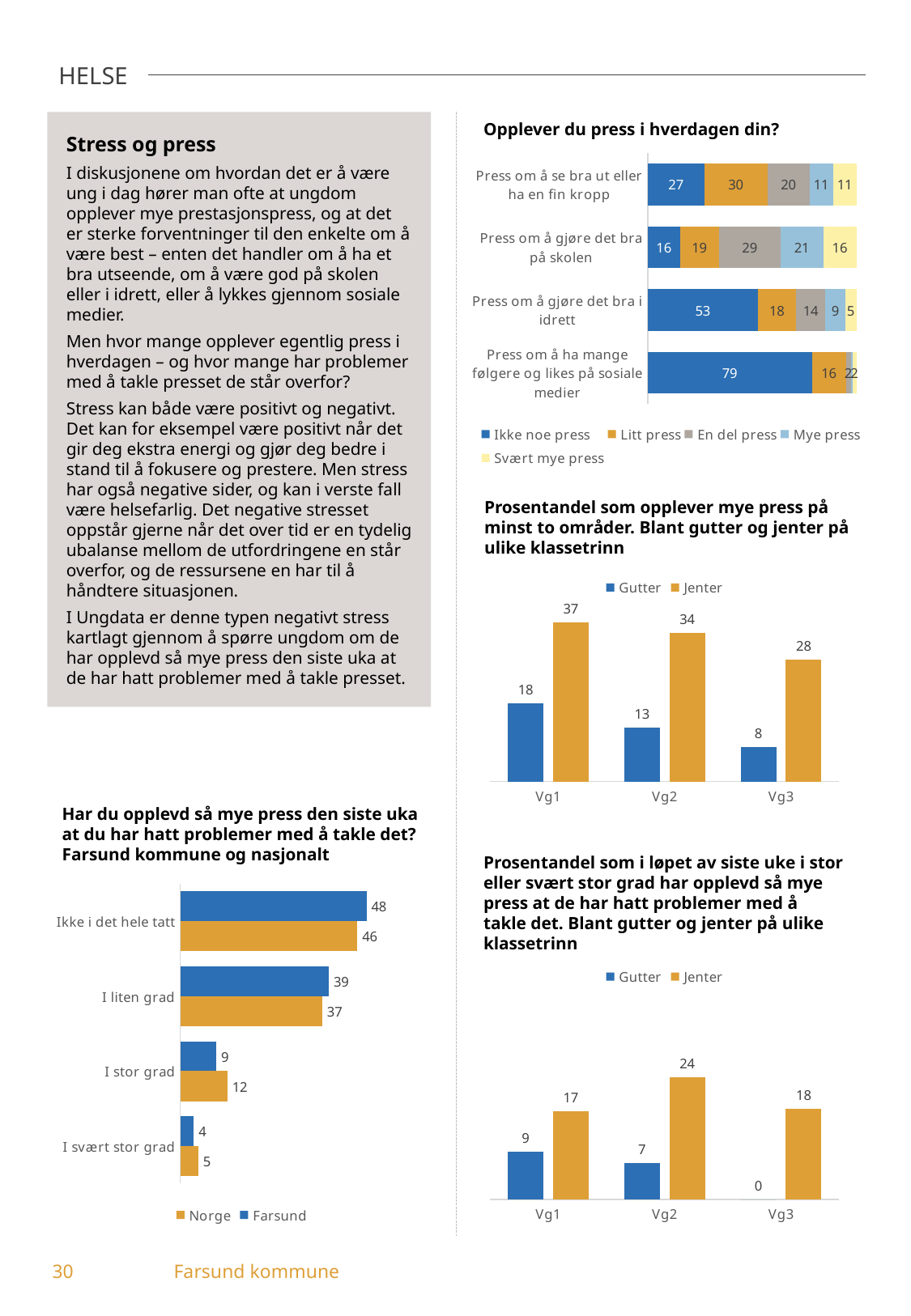
In the chart 'Opplever du press i hverdagen din?', which category has the highest value for 'Ikke noe press'? Press om å ha mange følgere og likes på sosiale medier In the chart 'Har du opplevd så mye press den siste uka at du har hatt problemer med å takle det?', how many categories are shown? 4 In the chart 'Prosentandel som opplever mye press på minst to områder', what is the difference between Jenter and Gutter at Vg1? 19 In the chart 'Har du opplevd så mye press den siste uka at du har hatt problemer med å takle det?', which is larger for 'Ikke i det hele tatt', Farsund or Norge? Farsund In the bottom-right chart about problems handling press among gutter and jenter, which class level has the highest value for Jenter? Vg2 In the chart 'Opplever du press i hverdagen din?', how many series does the legend list? 5 In the chart 'Har du opplevd så mye press den siste uka at du har hatt problemer med å takle det?', what is the value for Norge for 'I stor grad'? 12 In the chart 'Prosentandel som opplever mye press på minst to områder', what is the value for Jenter at Vg2? 34 In the chart 'Opplever du press i hverdagen din?', what is the value for 'Ikke noe press' for 'Press om å ha mange følgere og likes på sosiale medier'? 79 In the chart 'Prosentandel som opplever mye press på minst to områder', do the Gutter values rise or fall from Vg1 to Vg3? fall In the bottom-right chart about problems handling press among gutter and jenter, what is the value for Gutter at Vg3? 0 In the chart 'Opplever du press i hverdagen din?', what is the value for 'En del press' for 'Press om å gjøre det bra på skolen'? 29